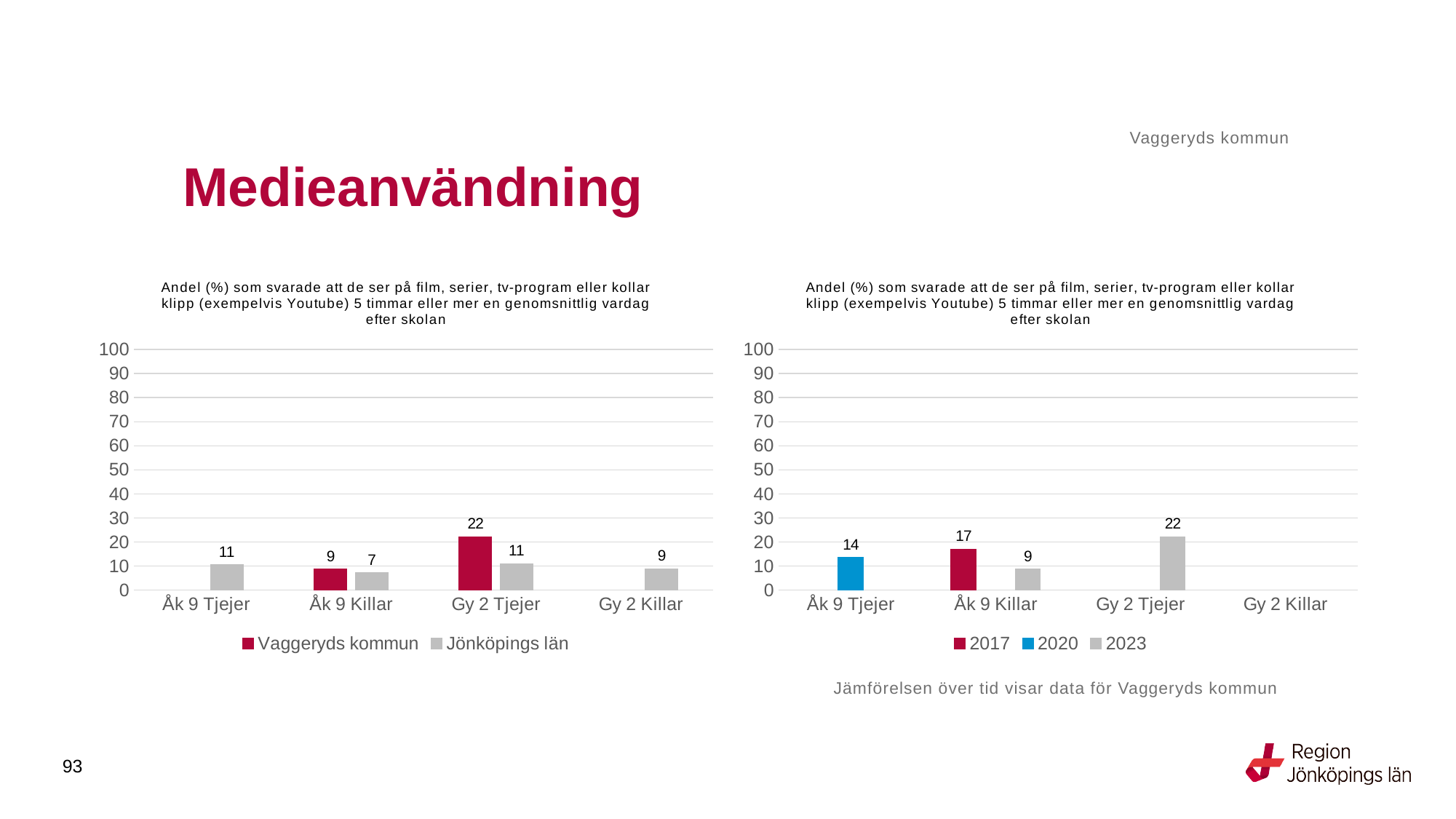
In the left chart, what is the value for Jönköpings län for Åk 9 Killar? 7 In the left chart, what is the difference between Vaggeryds kommun and Jönköpings län for Gy 2 Tjejer? 11 In the left chart, what is the value for Vaggeryds kommun for Gy 2 Tjejer? 22 In the left chart, which category has the highest Jönköpings län value? Åk 9 Tjejer and Gy 2 Tjejer (both 11) In the left chart, which is larger for Åk 9 Killar: Vaggeryds kommun or Jönköpings län? Vaggeryds kommun What kind of chart is the right chart? Bar chart How many series does the legend of the right chart list? 3 In the left chart, what is the value for Jönköpings län for Åk 9 Tjejer? 11 In the right chart, what is the 2020 value for Åk 9 Tjejer? 14 In the right chart, what is the 2017 value for Åk 9 Killar? 17 How many series does the legend of the left chart list? 2 In the right chart, what is the difference between the 2017 and 2023 values for Åk 9 Killar? 8